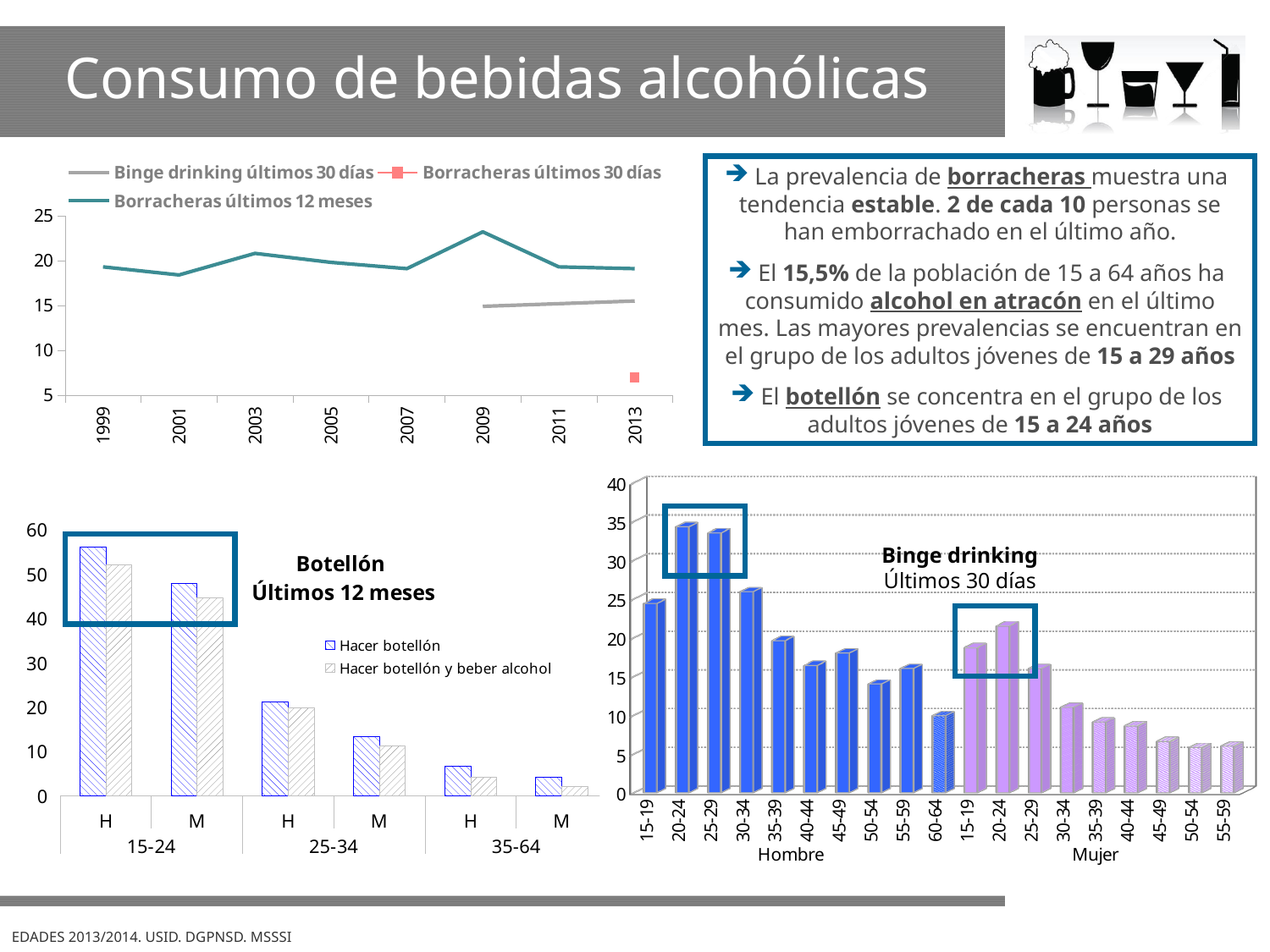
In the 'Binge drinking Últimos 30 días' bar chart, which age group among Hombre has the highest value? 20-24 In the top-left line chart, is the 'Borracheras últimos 12 meses' value for 2009 greater or less than 20? greater How many series does the legend of the top-left line chart list? 3 In the top-left line chart, in which year does the 'Borracheras últimos 12 meses' line reach its highest value? 2009 What kind of chart is the top-left chart on the slide? line chart In the 'Botellón Últimos 12 meses' bar chart, is the 'Hacer botellón' value for H in the 15-24 group greater or less than 50? greater In the 'Botellón Últimos 12 meses' bar chart, how many series does the legend list? 2 In the top-left line chart, which series has the higher value in 2013: 'Borracheras últimos 12 meses' or 'Binge drinking últimos 30 días'? Borracheras últimos 12 meses In the 'Binge drinking Últimos 30 días' bar chart, which is larger: the value for Hombre 15-19 or Mujer 15-19? Hombre 15-19 In the top-left line chart, is the 'Binge drinking últimos 30 días' value for 2013 greater or less than 20? less In the 'Botellón Últimos 12 meses' bar chart, which category has the highest 'Hacer botellón' value? H, 15-24